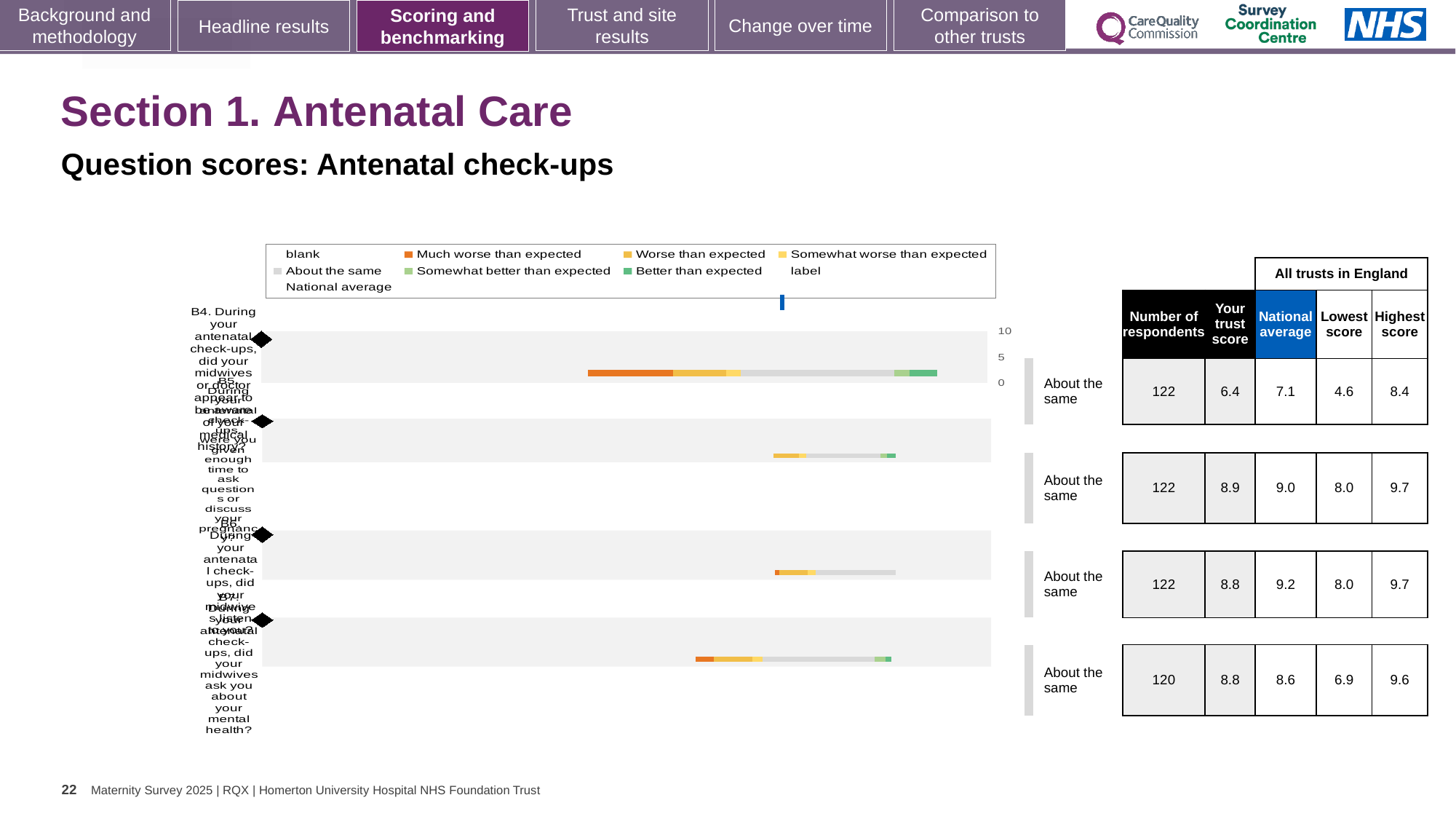
What is the 'Your trust score' for the first question (B4) in the table beside the chart? 6.4 What is the difference between the highest score and the lowest score for the first question (B4)? 3.8 Which question has the lowest 'Your trust score'? B4 (the first question) What benchmark category is shown for each of the four questions? About the same What is the title of the chart section on the slide? Question scores: Antenatal check-ups How many questions (bars) are plotted in the chart? 4 What kind of chart is shown on the slide? bar chart What is the highest score across all trusts in England for the second question? 9.7 What is the national average for the first question (B4)? 7.1 For the fourth (bottom) question, which is larger: the trust score or the national average? the trust score (8.8) What is the number of respondents for the fourth (bottom) question? 120 What is the lowest score across all trusts in England for the third question? 8.0